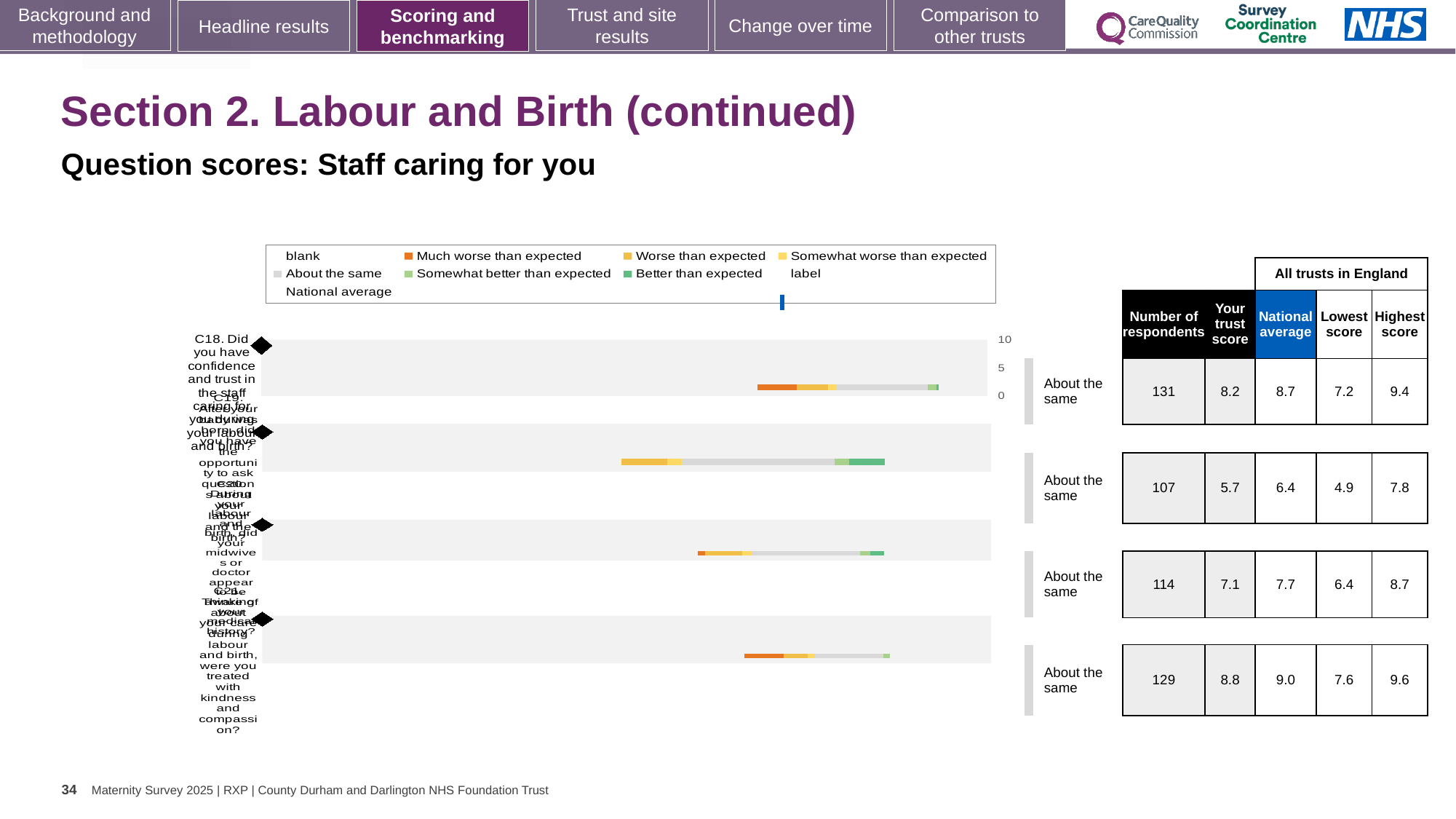
What is the national average for the first row (C18)? 8.7 What is the highest score among all trusts in England for the fourth row of the table? 9.6 Is the trust score in the third row larger or smaller than its national average? smaller How many question rows (categories) are plotted in the chart? 4 What kind of chart is shown on the slide? bar chart Which row of the table has the lowest trust score? the second row (5.7) What colour represents 'Much worse than expected' in the legend? orange What benchmark category is shown for every row of the chart? About the same What is the number of respondents for the first row (C18, confidence and trust in the staff caring for you)? 131 What is the lowest score among all trusts in England for the second row of the table? 4.9 What is the difference between the national average and the trust score in the first row (C18)? 0.5 What is the trust score for the first row (C18)? 8.2